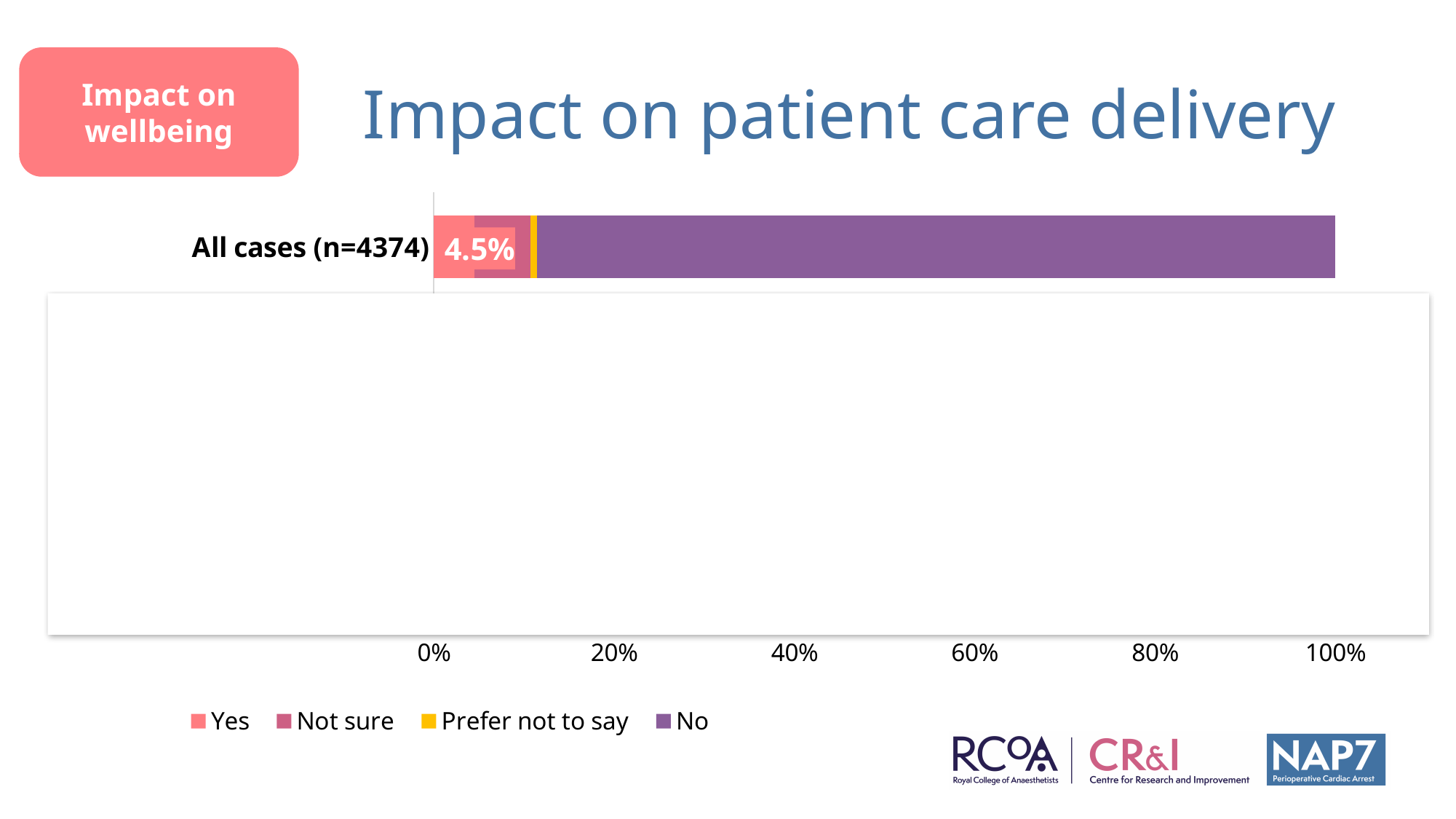
What colour represents the "No" series in the chart? Purple What percentage of all cases answered "Yes"? 4.5% Which response makes up the smallest share of the bar for All cases? Prefer not to say What is the title of the chart? Impact on patient care delivery What is the sample size shown in the category label? n=4374 Is the value for "No" greater or less than 80%? greater Which is larger for All cases, the "Yes" segment or the "No" segment? No Which response makes up the largest share of the bar for All cases? No How many series does the legend list? 4 What kind of chart is shown on the slide? Stacked bar chart Is the value for "Not sure" greater or less than 20%? less